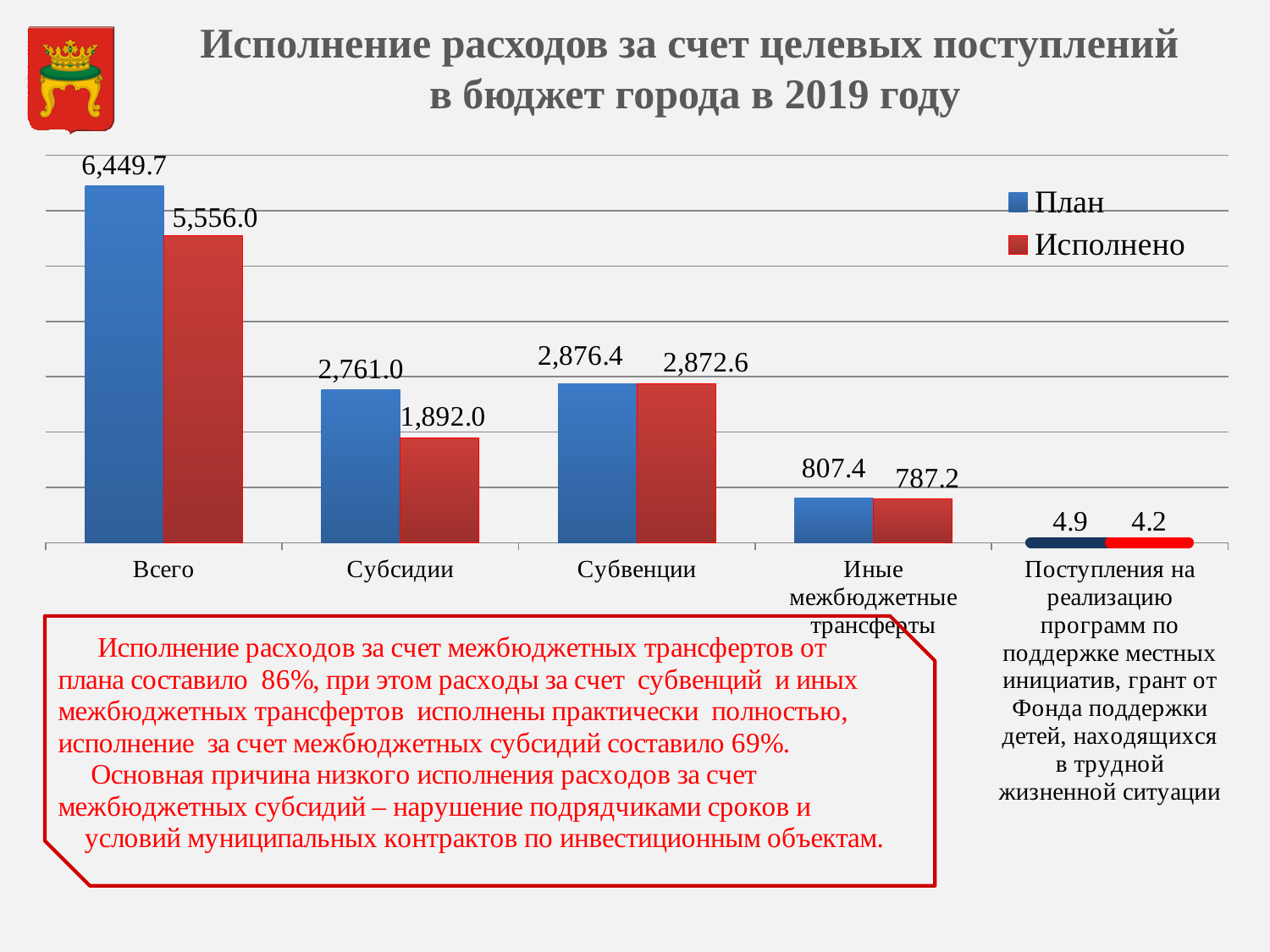
What is the План value for Всего? 6,449.7 How many categories are shown on the x axis of the chart? 5 What type of chart is shown on the slide? Bar chart What is the План value for Иные межбюджетные трансферты? 807.4 What is the difference between the План and Исполнено values for Субсидии? 869.0 What is the Исполнено value for Субвенции? 2,872.6 Which is larger for Субвенции: the План value or the Исполнено value? План What is the difference between the План and Исполнено values for Всего? 893.7 How many series does the legend list? 2 What is the Исполнено value for Субсидии? 1,892.0 Which category has the lowest Исполнено value? Поступления на реализацию программ по поддержке местных инициатив, грант от Фонда поддержки детей, находящихся в трудной жизненной ситуации Excluding Всего, which category has the highest План value? Субвенции